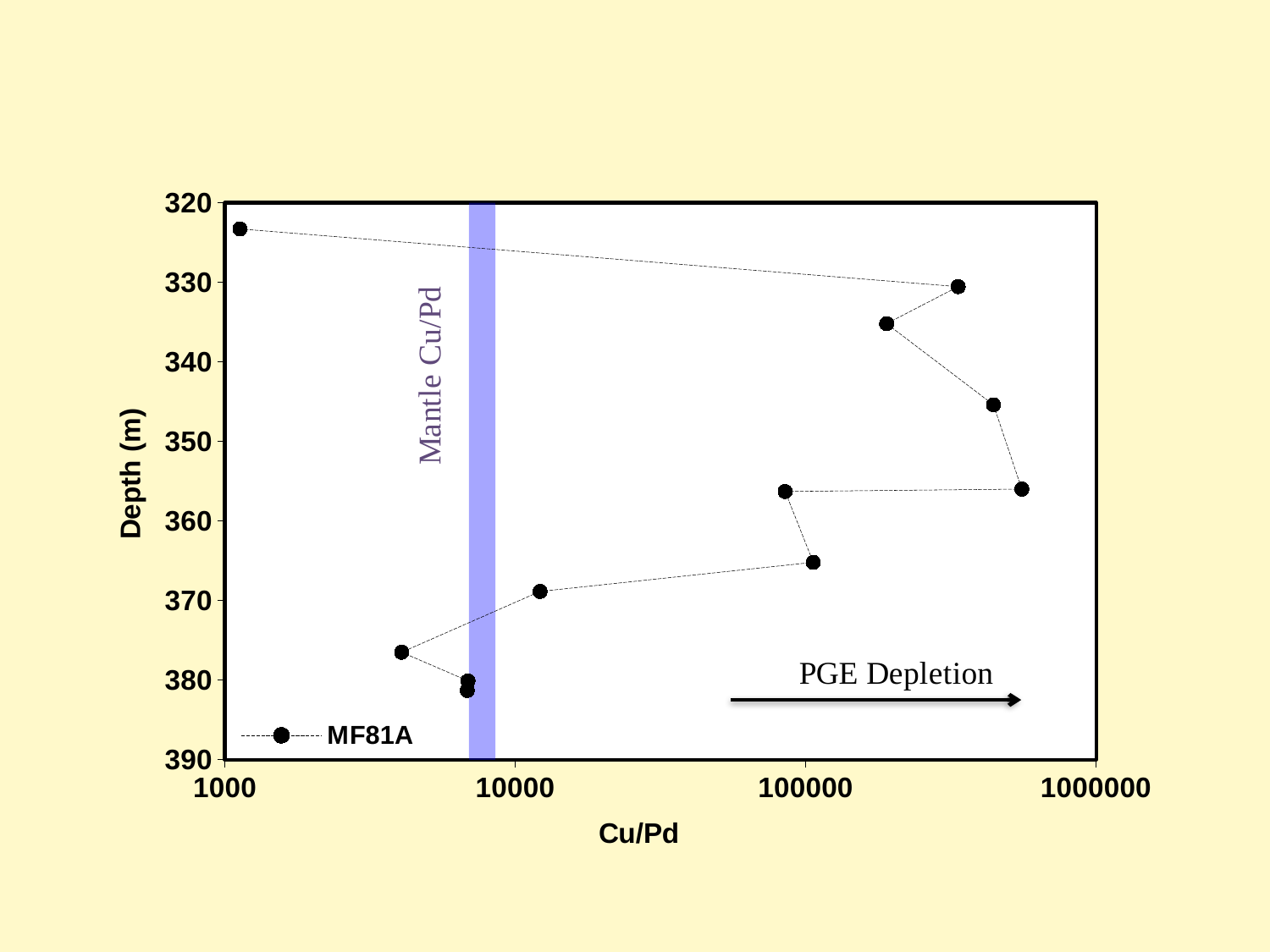
Is the Cu/Pd value of the deepest point (near 380 m depth) greater or less than 10000? less Is the highest Cu/Pd value plotted greater or less than 100000? greater Is the Cu/Pd value of the shallowest point (near 320 m depth) greater or less than 10000? less What is the largest value shown on the Cu/Pd axis? 1000000 What is the label of the x axis? Cu/Pd Which has the larger Cu/Pd value: the shallowest point or the deepest point? The deepest point How many series does the legend list? 1 What is the name of the series shown in the legend? MF81A What kind of chart is shown on the slide? Scatter (line) chart